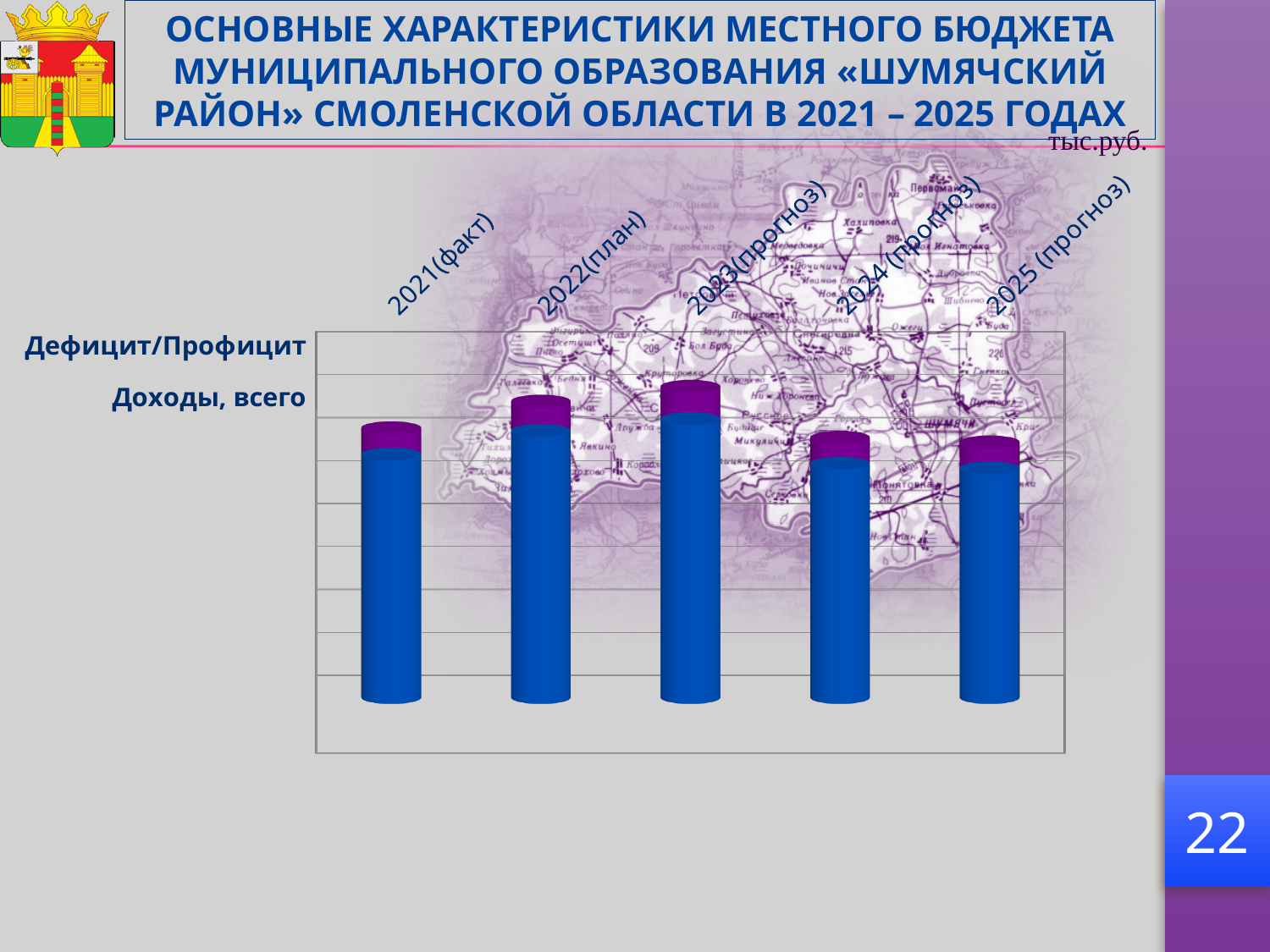
What unit of measurement is indicated for the chart? тыс.руб. Which bar is taller, 2022(план) or 2024 (прогноз)? 2022(план) Which year has the tallest bar on the chart? 2023(прогноз) Do the bar heights rise or fall from 2021(факт) to 2023(прогноз)? rise Which bar is taller, 2022(план) or 2021(факт)? 2022(план) What kind of chart is shown on the slide? bar chart How many categories (years) are plotted on the chart? 5 Do the bar heights rise or fall from 2023(прогноз) to 2025 (прогноз)? fall Which bar is taller, 2021(факт) or 2023(прогноз)? 2023(прогноз)